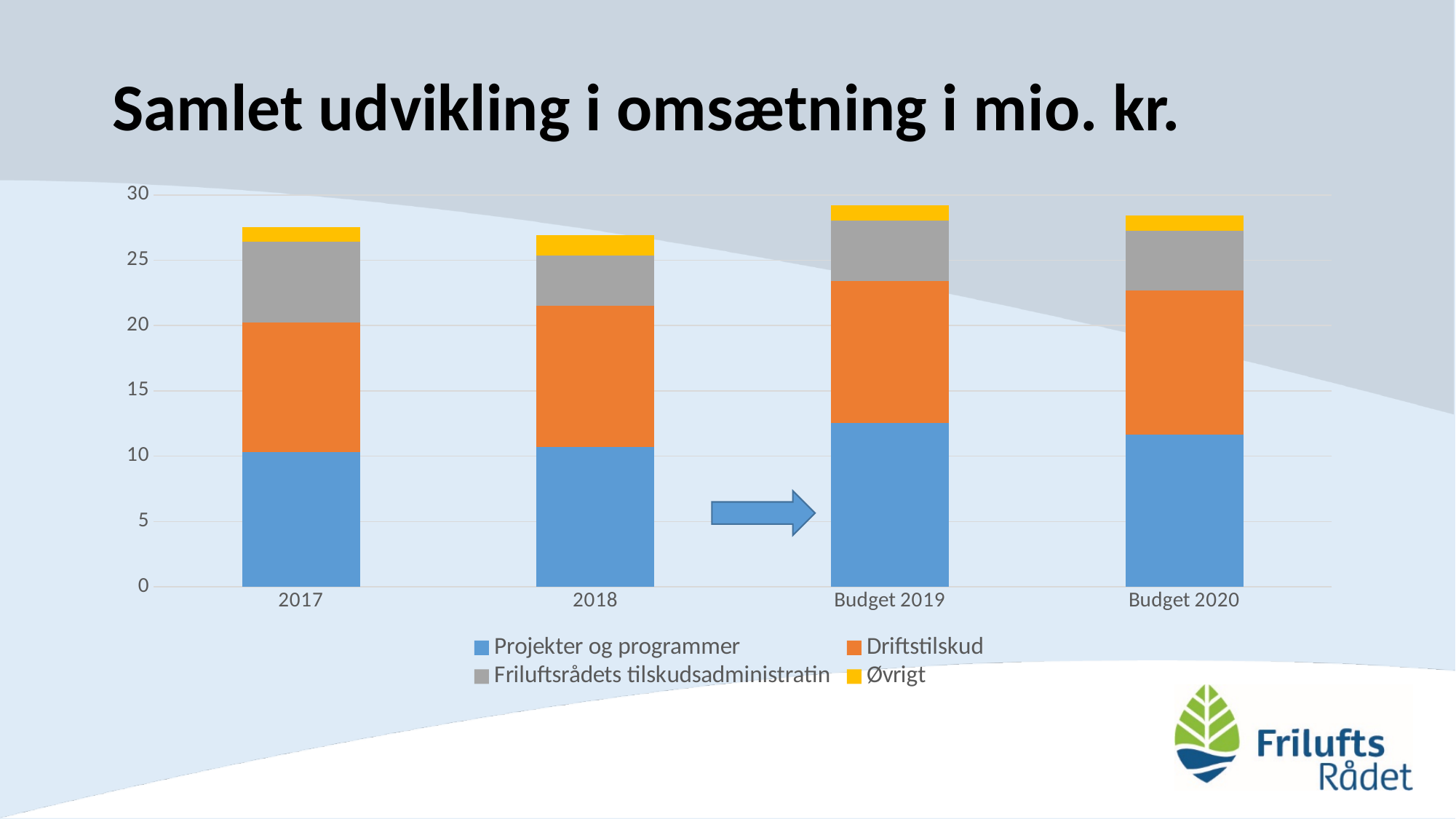
Is the total stacked bar for Budget 2019 greater or less than 25? greater Is the total stacked bar for 2018 greater or less than 30? less Is the value for "Projekter og programmer" in Budget 2019 greater or less than 15? less Which is larger: the "Projekter og programmer" segment for 2017 or for Budget 2019? Budget 2019 How many series does the chart's legend list? 4 What is the title of the chart on the slide? Samlet udvikling i omsætning i mio. kr. What kind of chart is shown on the slide? Stacked bar chart Which category has the tallest stacked bar overall? Budget 2019 How many categories are shown on the x axis of the chart? 4 Which is larger: the total stacked bar for 2018 or for Budget 2019? Budget 2019 Which colour represents the series "Øvrigt" in the chart? Yellow